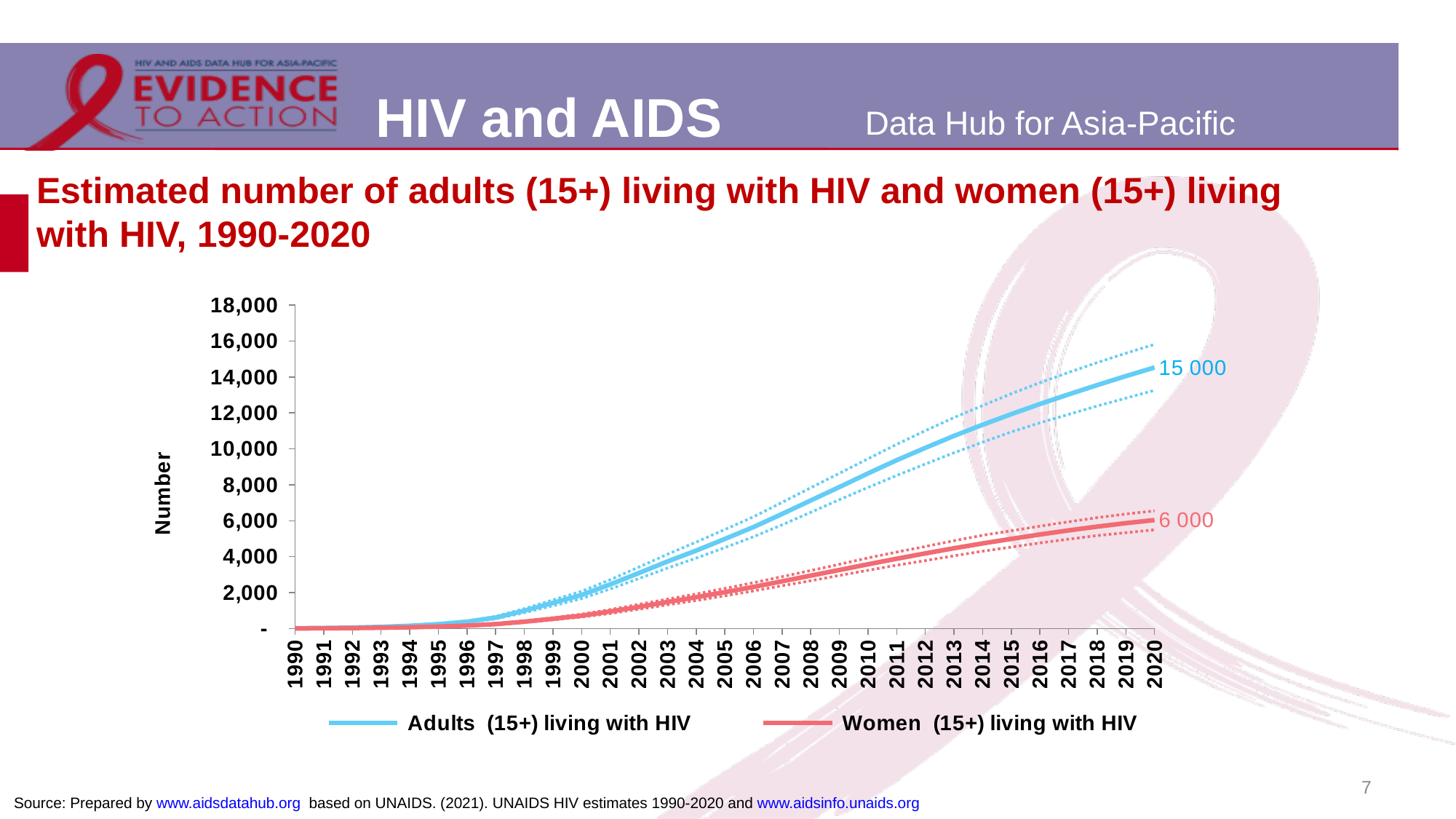
In 2020, which series has the larger value: Adults (15+) living with HIV or Women (15+) living with HIV? Adults (15+) living with HIV Does the number of adults (15+) living with HIV rise or fall from 1990 to 2020? rise What is the estimated number of women (15+) living with HIV in 2020? 6 000 Is the value for Women (15+) living with HIV in 2010 greater or less than 6,000? less How many series does the chart legend list? 2 Is the value for Adults (15+) living with HIV in 2015 greater or less than 10,000? greater Is the value for Adults (15+) living with HIV in 2005 greater or less than 8,000? less How many years are shown on the x axis of the chart? 31 What is the title of the y axis? Number What is the difference between the number of adults (15+) living with HIV and women (15+) living with HIV in 2020? 9 000 What kind of chart is shown on the slide? line chart What is the estimated number of adults (15+) living with HIV in 2020? 15 000